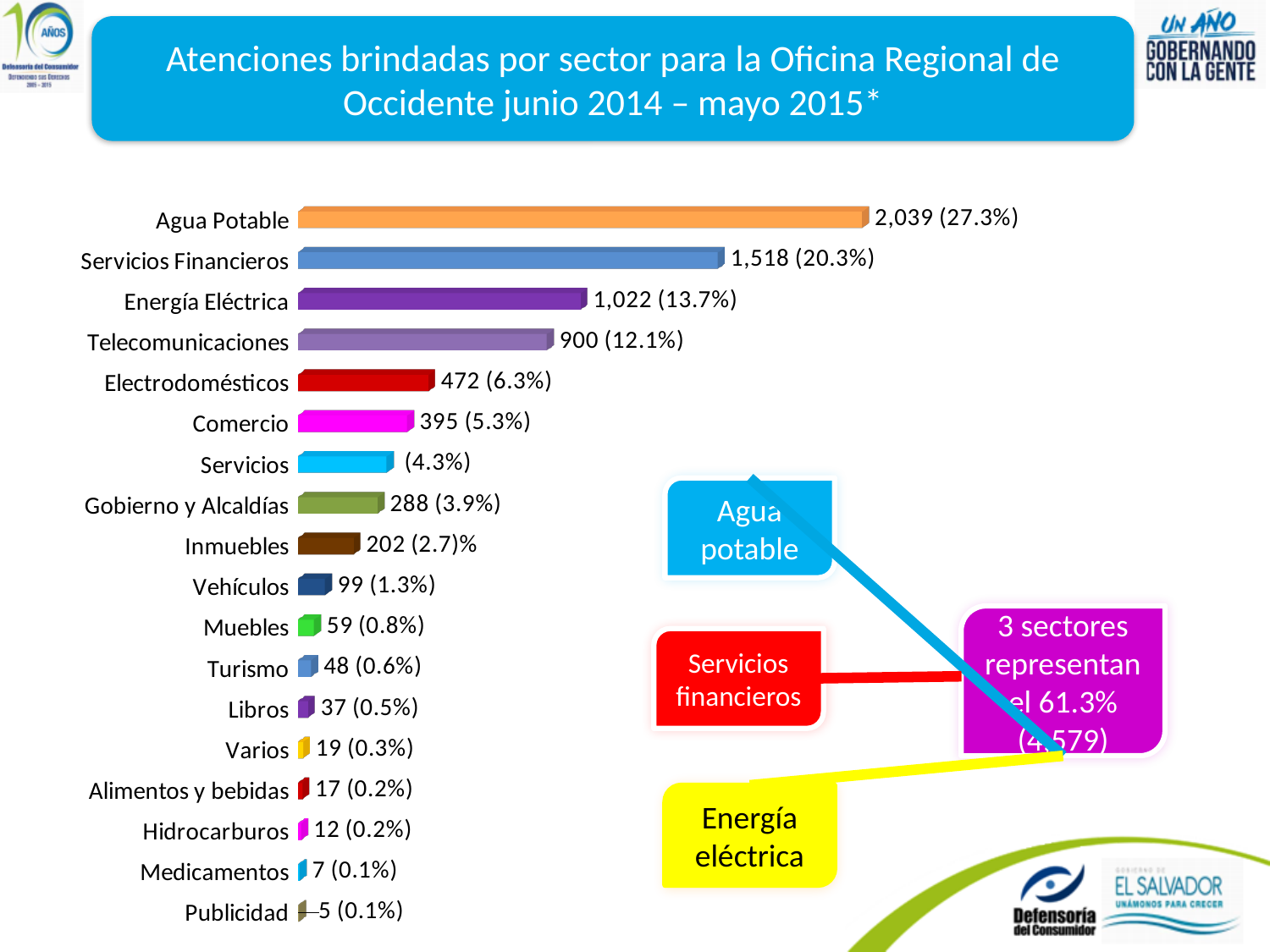
What percentage is shown for Electrodomésticos? 6.3% What kind of chart is shown on the slide? bar chart What is the difference in atenciones between Agua Potable and Servicios Financieros? 521 What is the value shown for Agua Potable? 2,039 (27.3%) What is the difference in atenciones between Energía Eléctrica and Telecomunicaciones? 122 What is the value shown for Telecomunicaciones? 900 (12.1%) According to the callout on the slide, what share do the top 3 sectors represent? 61.3% Which has more atenciones, Comercio or Gobierno y Alcaldías? Comercio How many sectors (categories) are plotted in the chart? 18 How many atenciones are shown for Vehículos? 99 Which sector has the highest number of atenciones? Agua Potable Which sector has the lowest number of atenciones? Publicidad